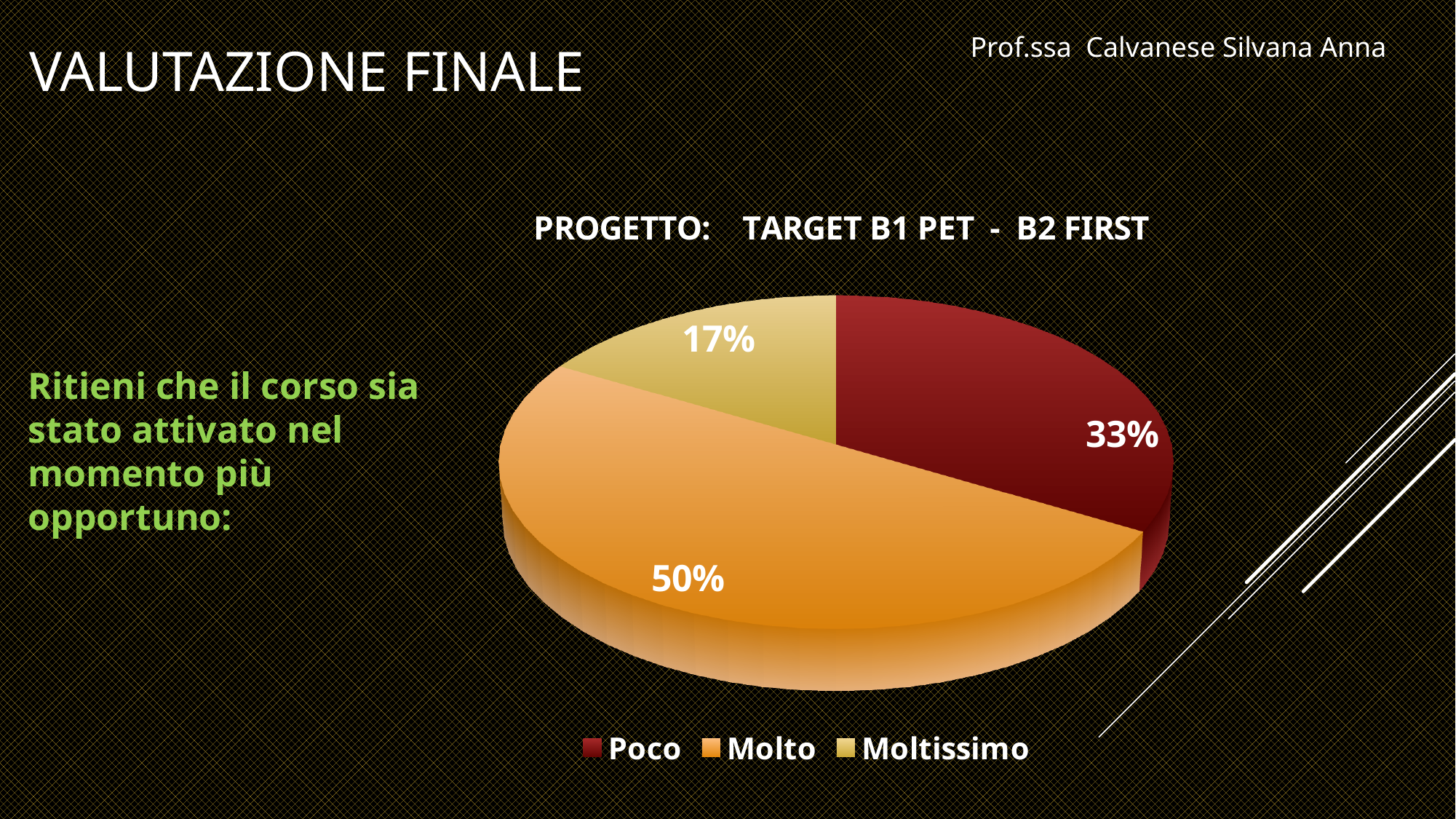
How many categories does the legend list? 3 What percentage of the pie is labelled Moltissimo? 17% What is the difference in percentage points between the Poco and Moltissimo slices? 16 Which category has the smallest share of the pie? Moltissimo What percentage of the pie is labelled Poco? 33% What colour is the Poco slice in the pie chart? dark red What percentage of the pie is labelled Molto? 50% What kind of chart is shown on the slide? pie chart Which category has the largest share of the pie? Molto Which slice is larger, Poco or Moltissimo? Poco What is the difference in percentage points between the Molto and Poco slices? 17 What is the title of the chart? PROGETTO: TARGET B1 PET - B2 FIRST